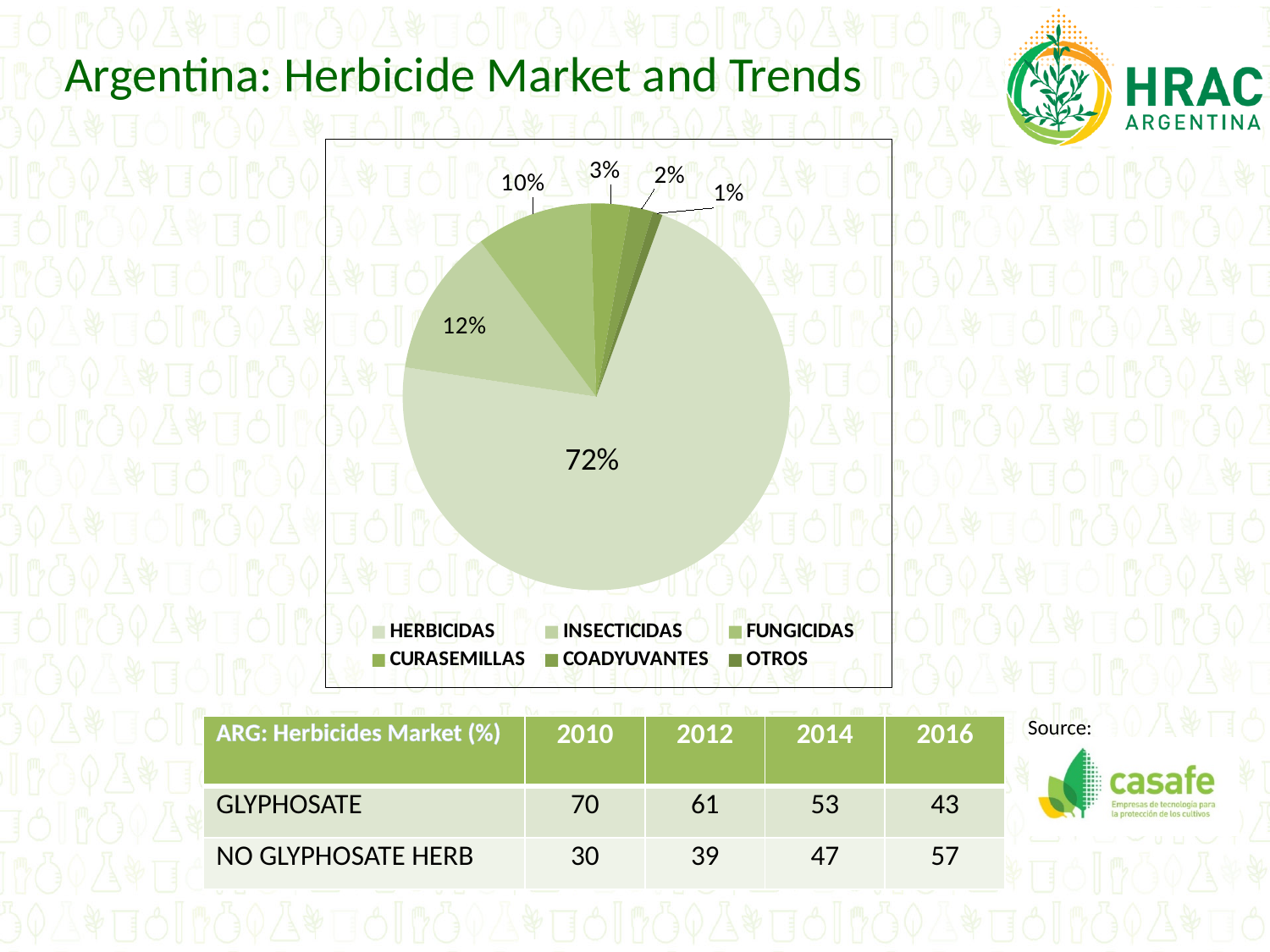
What is the title of the slide containing the pie chart? Argentina: Herbicide Market and Trends What share of the pie chart does HERBICIDAS represent? 72% What is the difference between the HERBICIDAS and INSECTICIDAS shares in the pie chart? 60% What is the value shown for CURASEMILLAS in the pie chart? 3% Which category has the smallest slice in the pie chart? OTROS What is the value shown for FUNGICIDAS in the pie chart? 10% Which category has the largest slice in the pie chart? HERBICIDAS What is the value shown for OTROS in the pie chart? 1% How many categories does the pie chart legend list? 6 Which is larger in the pie chart, FUNGICIDAS or COADYUVANTES? FUNGICIDAS What type of chart is shown on the slide? pie chart What is the value shown for INSECTICIDAS in the pie chart? 12%